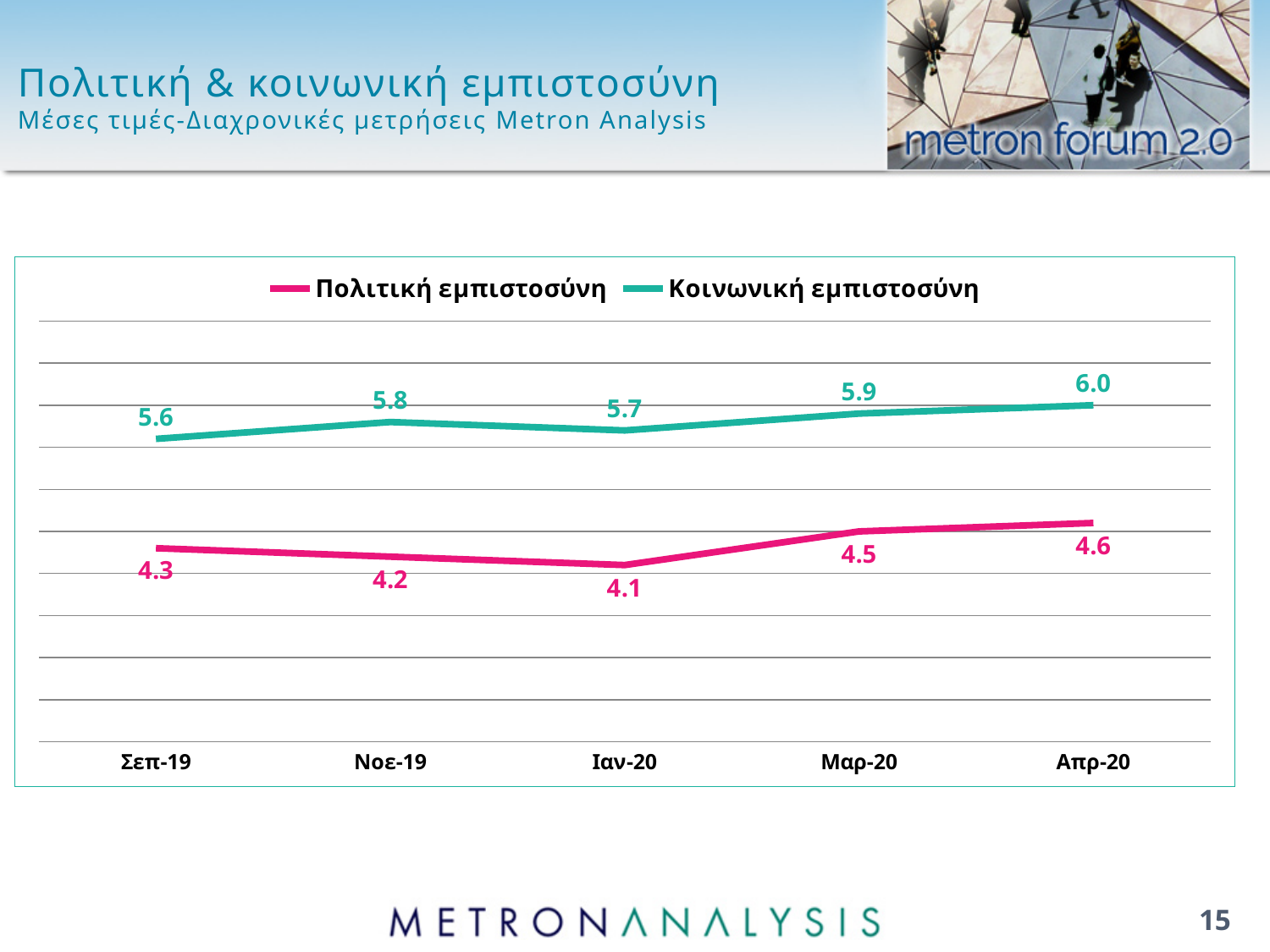
Does Πολιτική εμπιστοσύνη rise or fall from Ιαν-20 to Απρ-20? Rise What is the value of Κοινωνική εμπιστοσύνη for Απρ-20? 6.0 What colour is the line for Πολιτική εμπιστοσύνη? Pink/magenta In which period is Πολιτική εμπιστοσύνη lowest? Ιαν-20 What kind of chart is shown on the slide? Line chart In which period is Κοινωνική εμπιστοσύνη highest? Απρ-20 What is the value of Κοινωνική εμπιστοσύνη for Σεπ-19? 5.6 What is the difference between Κοινωνική εμπιστοσύνη and Πολιτική εμπιστοσύνη in Μαρ-20? 1.4 How many time periods are shown on the x axis? 5 What is the value of Πολιτική εμπιστοσύνη for Ιαν-20? 4.1 Which is larger in Νοε-19: Πολιτική εμπιστοσύνη or Κοινωνική εμπιστοσύνη? Κοινωνική εμπιστοσύνη How many series does the legend list? 2